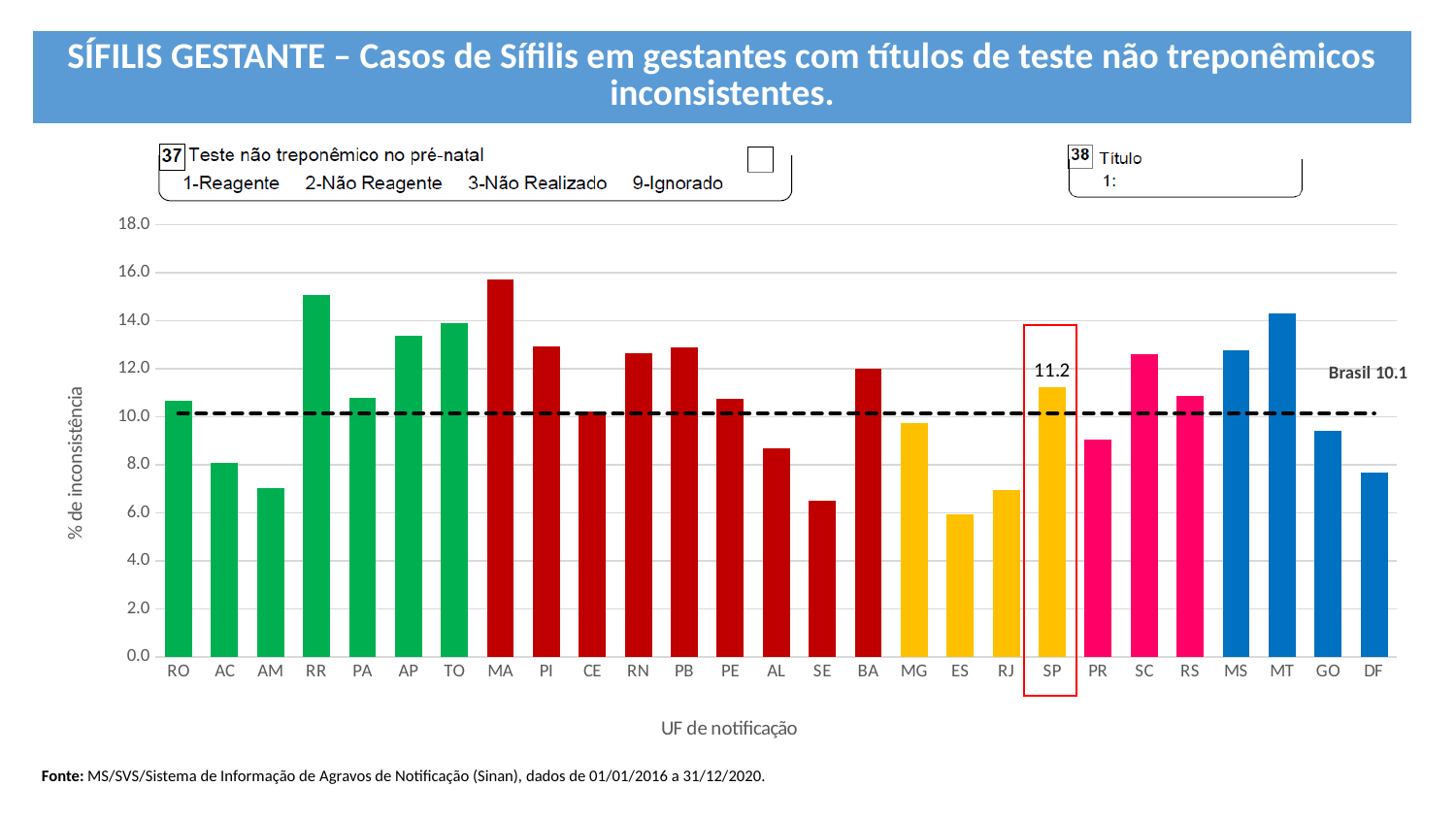
How many UFs (categories) are plotted on the x axis? 27 Is the value for PR greater or less than 10.0? less Which has the larger value, RR or PA? RR Which UF has the highest % de inconsistência? MA Is the value for BA greater or less than 10.0? greater Is the value for RR greater or less than 14.0? greater What is the label of the vertical axis? % de inconsistência What type of chart is shown on the slide? bar chart What is the value shown for SP? 11.2 Which UF has the lowest % de inconsistência? ES What value is shown for Brasil by the dashed reference line? 10.1